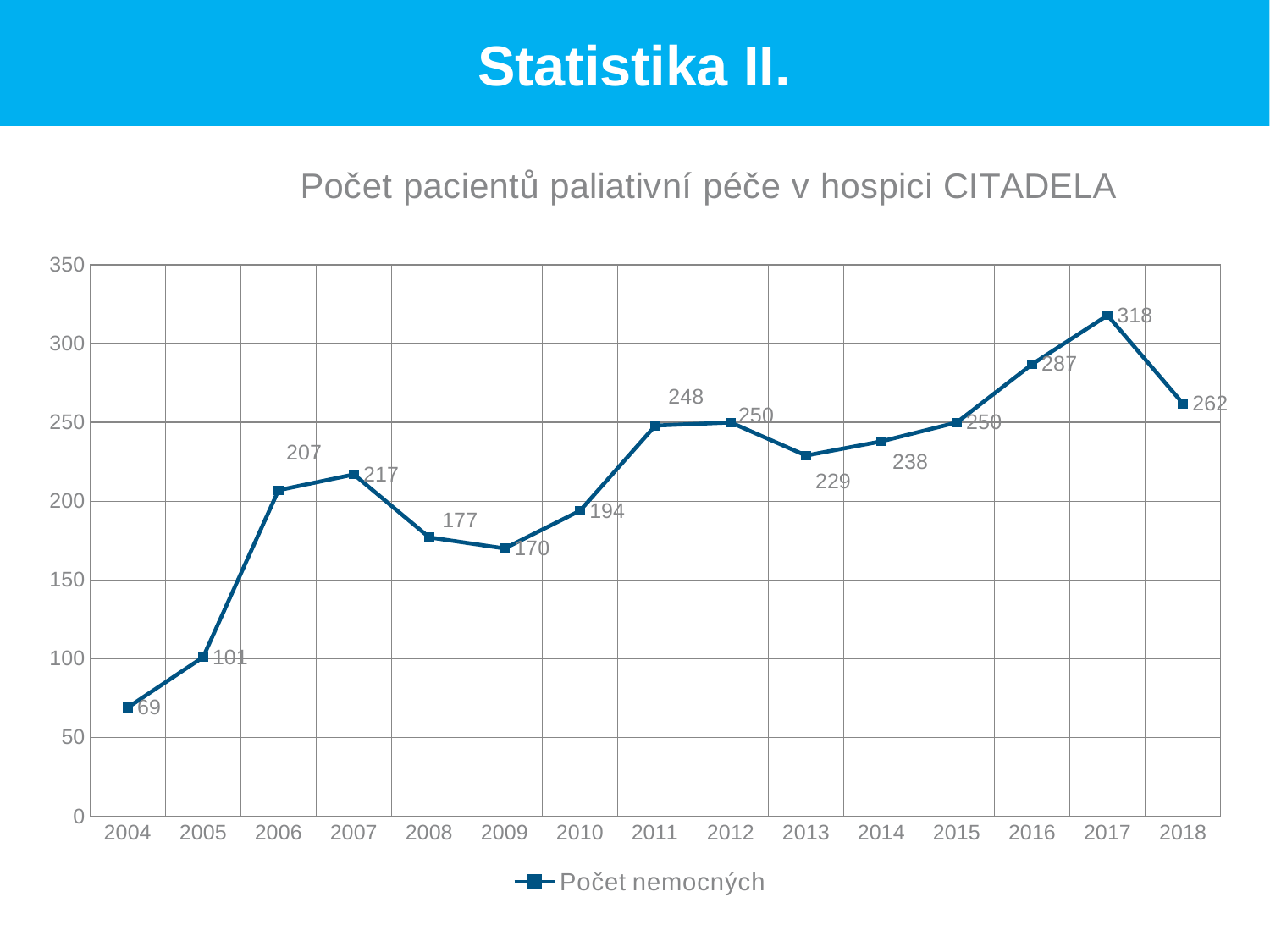
Which year has the highest value? 2017 How many years are plotted on the x axis? 15 Is the value for 2016 greater or less than 250? greater What is the value for 2017? 318 Which year has the lowest value? 2004 Which is larger, the value for 2006 or the value for 2007? 2007 What is the name of the series in the legend? Počet nemocných What is the value for 2009? 170 What is the value for 2004? 69 How many series does the legend list? 1 What is the difference between the values for 2017 and 2018? 56 What kind of chart is shown? line chart